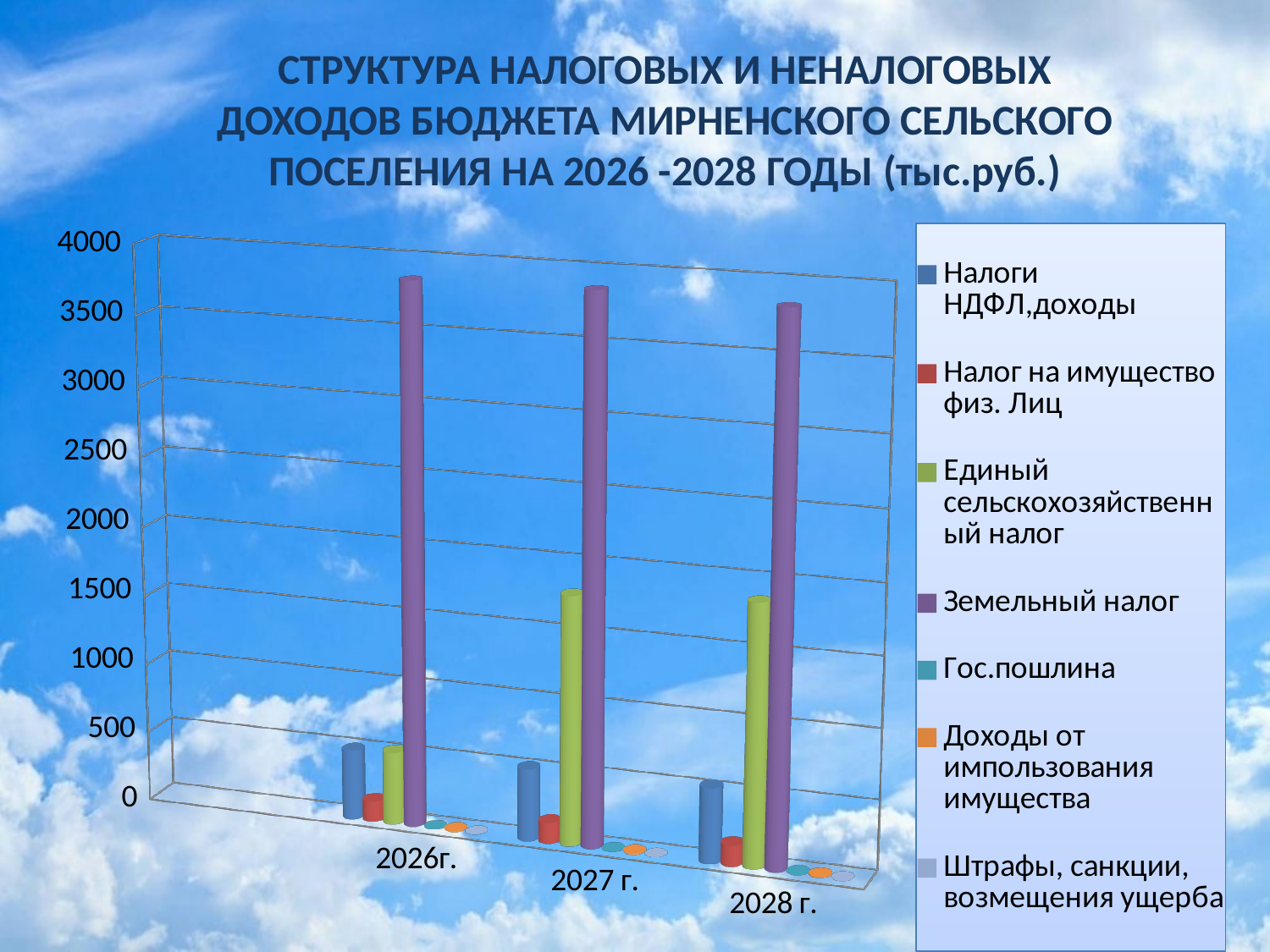
What colour represents Земельный налог in the chart legend? purple Which series has the highest value in 2026г.? Земельный налог Is the value of Земельный налог for 2026г. greater or less than 3500? greater Is the value of Единый сельскохозяйственный налог for 2027 г. greater or less than 1000? greater How many series does the chart legend list? 7 In 2027 г., which is larger: Единый сельскохозяйственный налог or Налоги НДФЛ,доходы? Единый сельскохозяйственный налог Which series has the highest value in 2027 г.? Земельный налог How many year categories are shown on the x axis of the chart? 3 What kind of chart is shown on the slide? bar chart